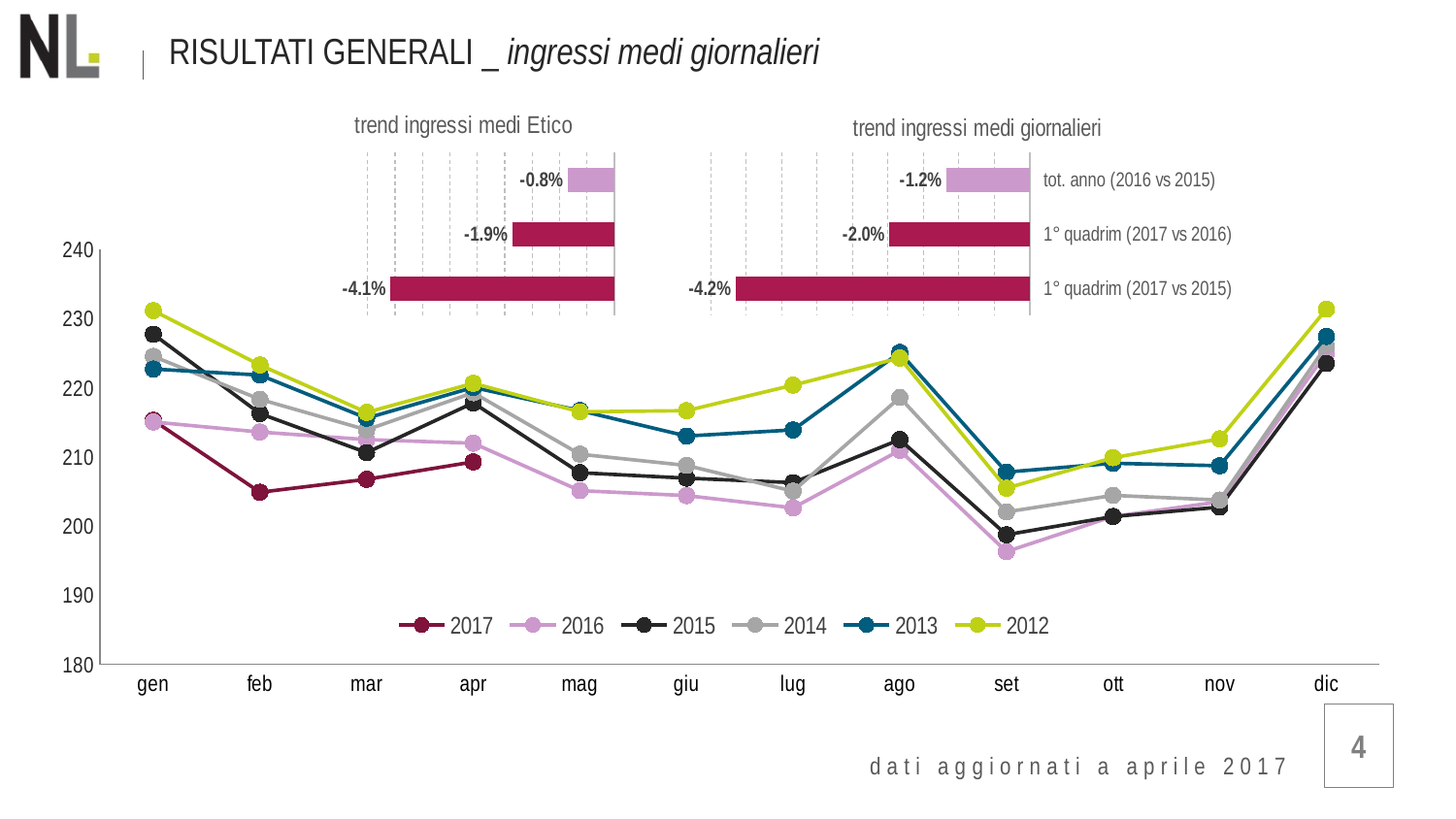
In the 'trend ingressi medi Etico' chart, which category shows the largest decline? 1° quadrim (2017 vs 2015) In the large monthly chart, is the value for 2016 in set greater or less than 200? less In the 'trend ingressi medi giornalieri' chart, what is the value for tot. anno (2016 vs 2015)? -1.2% In the large monthly chart at the bottom of the slide, how many months are shown on the x axis? 12 In the 'trend ingressi medi Etico' chart, what is the value for 1° quadrim (2017 vs 2015)? -4.1% In the 'trend ingressi medi giornalieri' chart, what is the difference between the tot. anno (2016 vs 2015) value and the 1° quadrim (2017 vs 2015) value? 3.0 percentage points In the large monthly chart, is the value for 2017 in feb greater or less than 210? less In the large monthly chart at the bottom of the slide, how many series does the legend list? 6 What kind of chart is the large monthly chart at the bottom of the slide? line chart In the 'trend ingressi medi Etico' chart, how many bars are shown? 3 In the 'trend ingressi medi Etico' chart, what is the value for 1° quadrim (2017 vs 2016)? -1.9% In the 'trend ingressi medi giornalieri' chart, what is the value for 1° quadrim (2017 vs 2016)? -2.0%